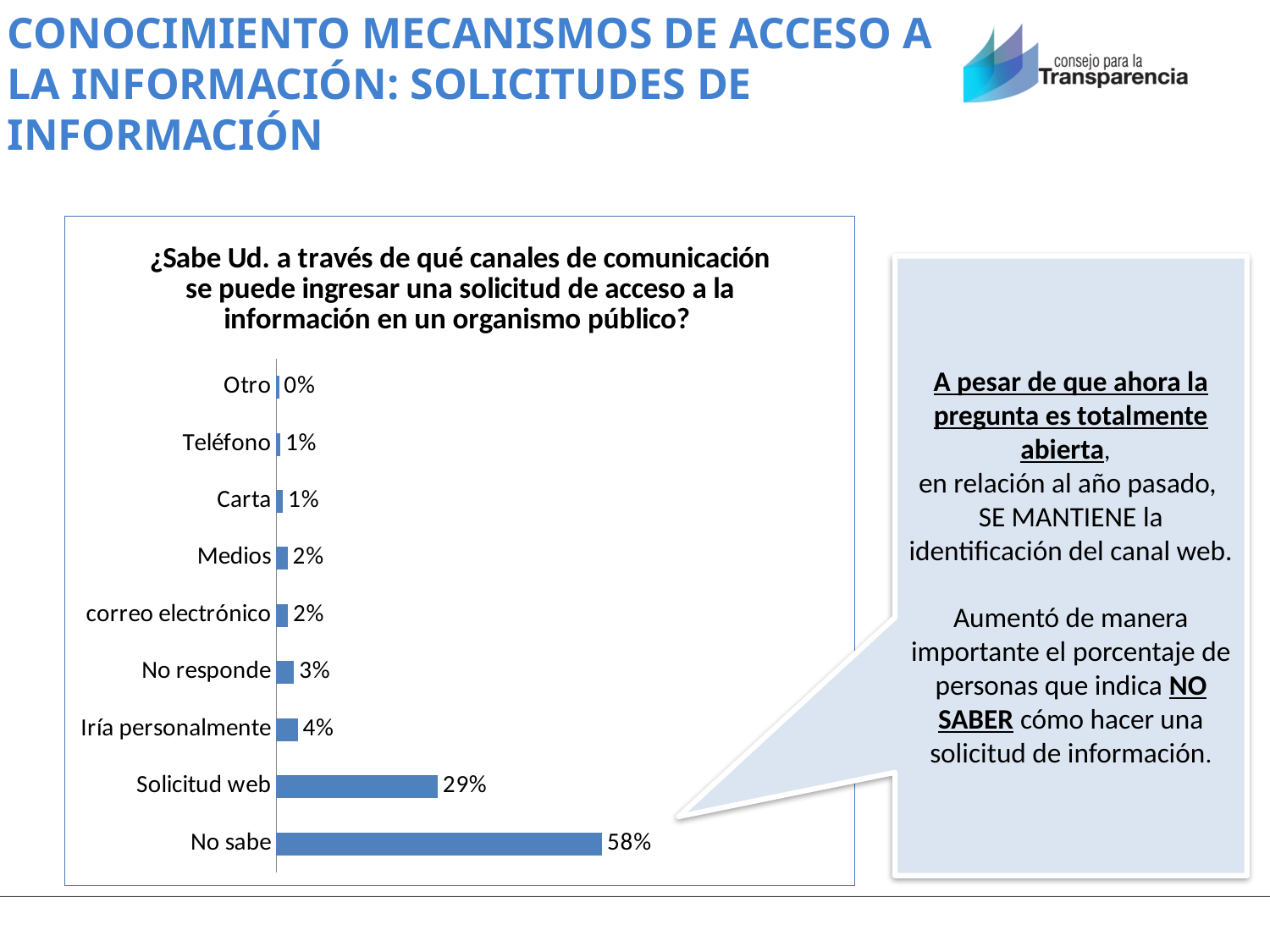
What percentage of respondents answered "No sabe"? 58% What is the difference between the values for "No sabe" and "Solicitud web"? 29% How many categories are shown in the chart? 9 What is the value for "Iría personalmente"? 4% Which category has the lowest value? Otro What is the title of the chart? ¿Sabe Ud. a través de qué canales de comunicación se puede ingresar una solicitud de acceso a la información en un organismo público? Which is larger, the value for "Iría personalmente" or the value for "Medios"? Iría personalmente What is the value for "Teléfono"? 1% What kind of chart is shown on the slide? Bar chart What is the value for "No responde"? 3% What is the value for "Solicitud web"? 29% Which category has the highest value? No sabe